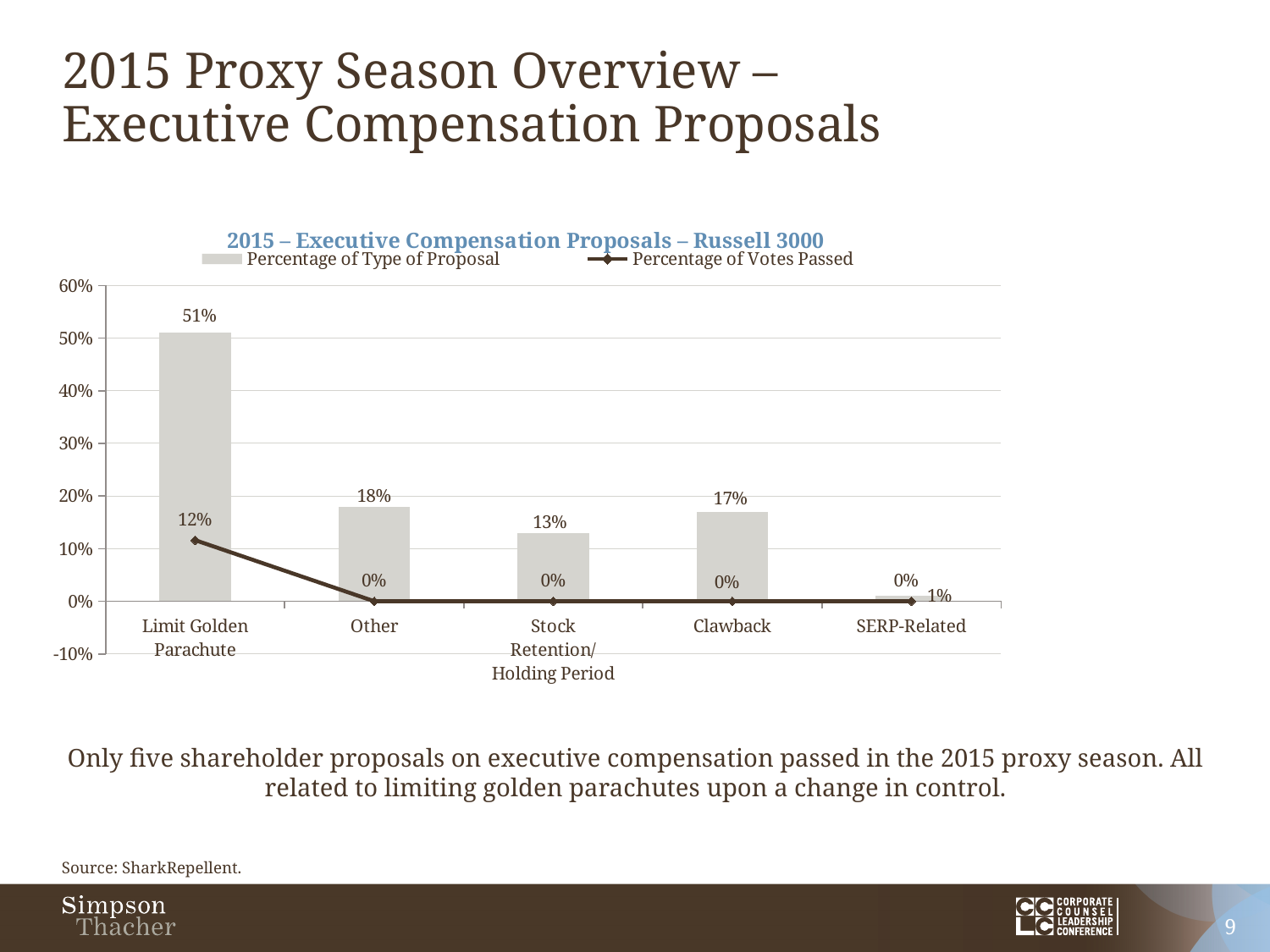
Which category has the highest Percentage of Type of Proposal? Limit Golden Parachute What is the difference between the Percentage of Type of Proposal for Other and for Stock Retention/Holding Period? 5% What is the Percentage of Type of Proposal for SERP-Related? 1% How many series does the legend list? 2 What kind of chart is used to show the Percentage of Type of Proposal? Bar chart What is the Percentage of Type of Proposal for Clawback? 17% What is the Percentage of Type of Proposal for Limit Golden Parachute? 51% Which category has the lowest Percentage of Type of Proposal? SERP-Related What is the Percentage of Votes Passed for Limit Golden Parachute? 12% Which has a larger Percentage of Type of Proposal, Other or Clawback? Other How many proposal categories are shown on the x axis? 5 What is the title of the chart? 2015 – Executive Compensation Proposals – Russell 3000